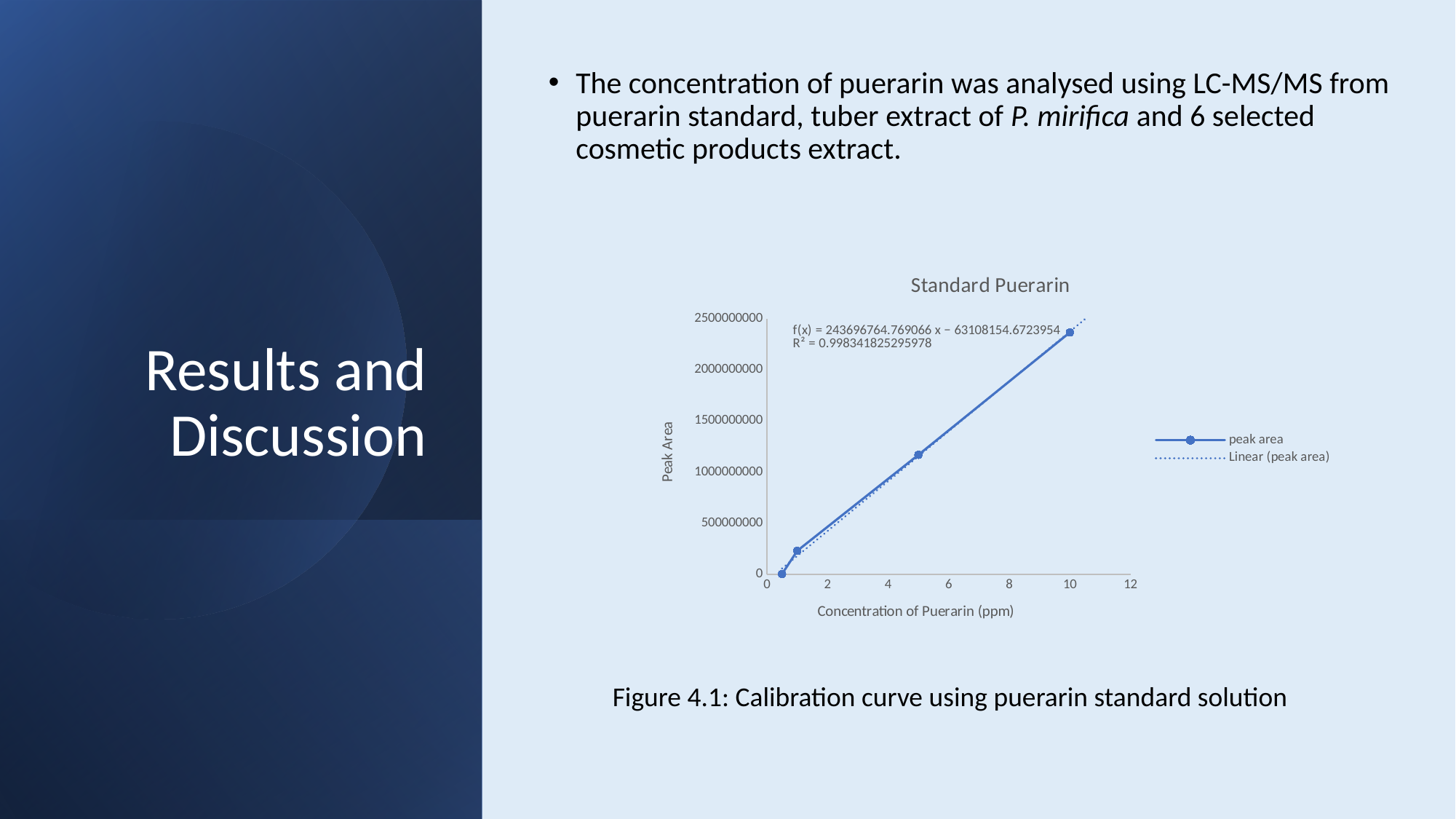
Does the peak area rise or fall as the concentration of puerarin increases? rise What kind of chart is shown on the slide? line chart How many data points are plotted for the peak area series? 4 Is the peak area at 1 ppm greater or less than 500000000? less How many series does the chart's legend list? 2 What R² value is printed on the chart for the linear trendline? 0.998341825295978 Is the peak area at 5 ppm greater or less than 1000000000? greater What is the title of the chart? Standard Puerarin At which concentration (ppm) is the peak area highest? 10 Is the peak area at 10 ppm greater or less than 2000000000? greater